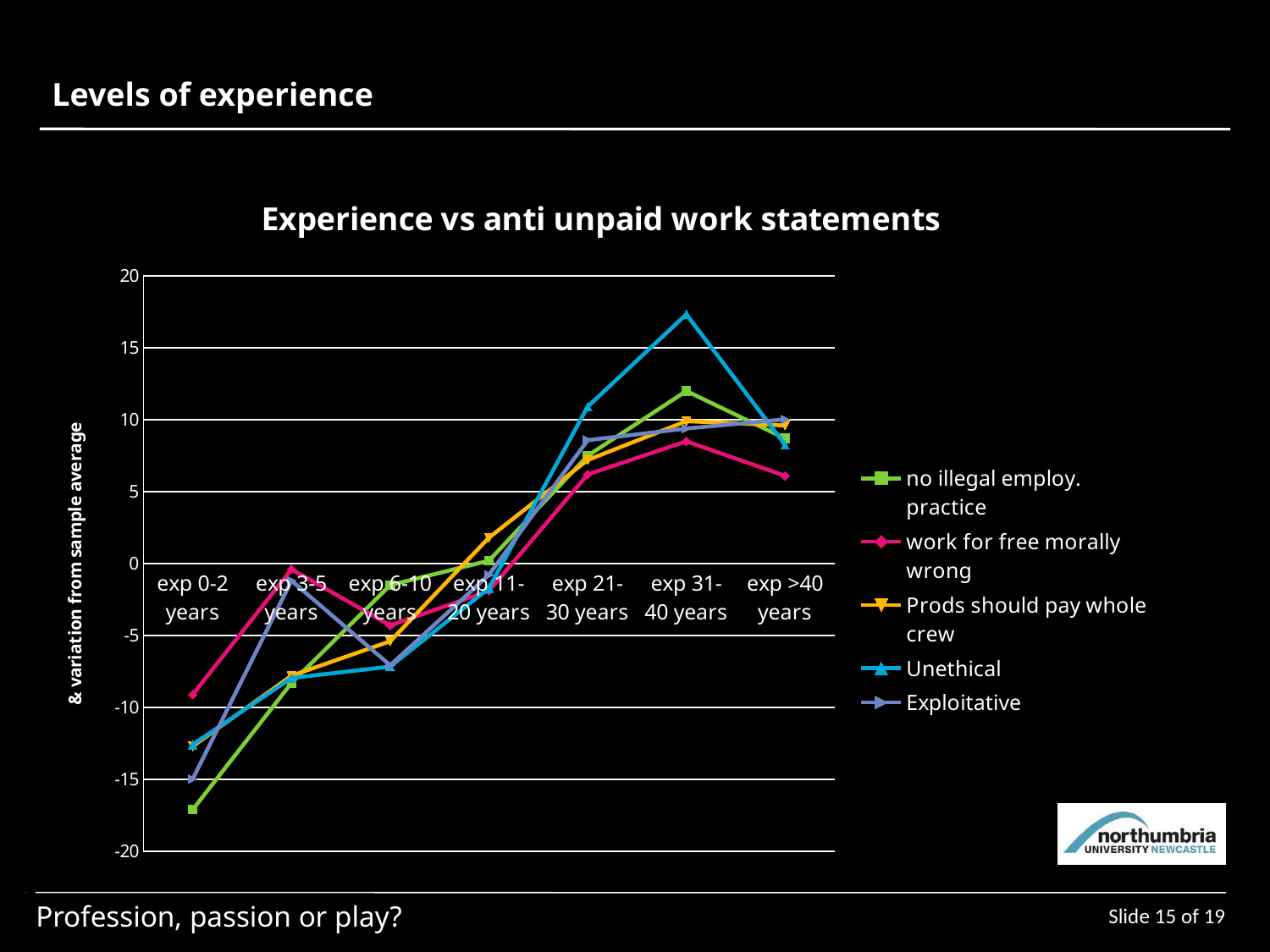
Is the value for 'no illegal employ. practice' at exp 0-2 years greater or less than -15? less What type of chart is shown on the slide? line chart What is the label on the vertical axis? & variation from sample average How many series does the legend list? 5 Does the 'no illegal employ. practice' series rise or fall from exp 0-2 years to exp 31-40 years? rise What is the title of the chart? Experience vs anti unpaid work statements Which series reaches the highest value anywhere on the chart? Unethical How many experience categories are plotted along the x axis? 7 Is the value for Unethical at exp 31-40 years greater or less than 15? greater In which experience category is the 'no illegal employ. practice' series at its lowest? exp 0-2 years At exp 31-40 years, which is larger: Unethical or 'work for free morally wrong'? Unethical In which experience category does the Unethical series reach its highest value? exp 31-40 years